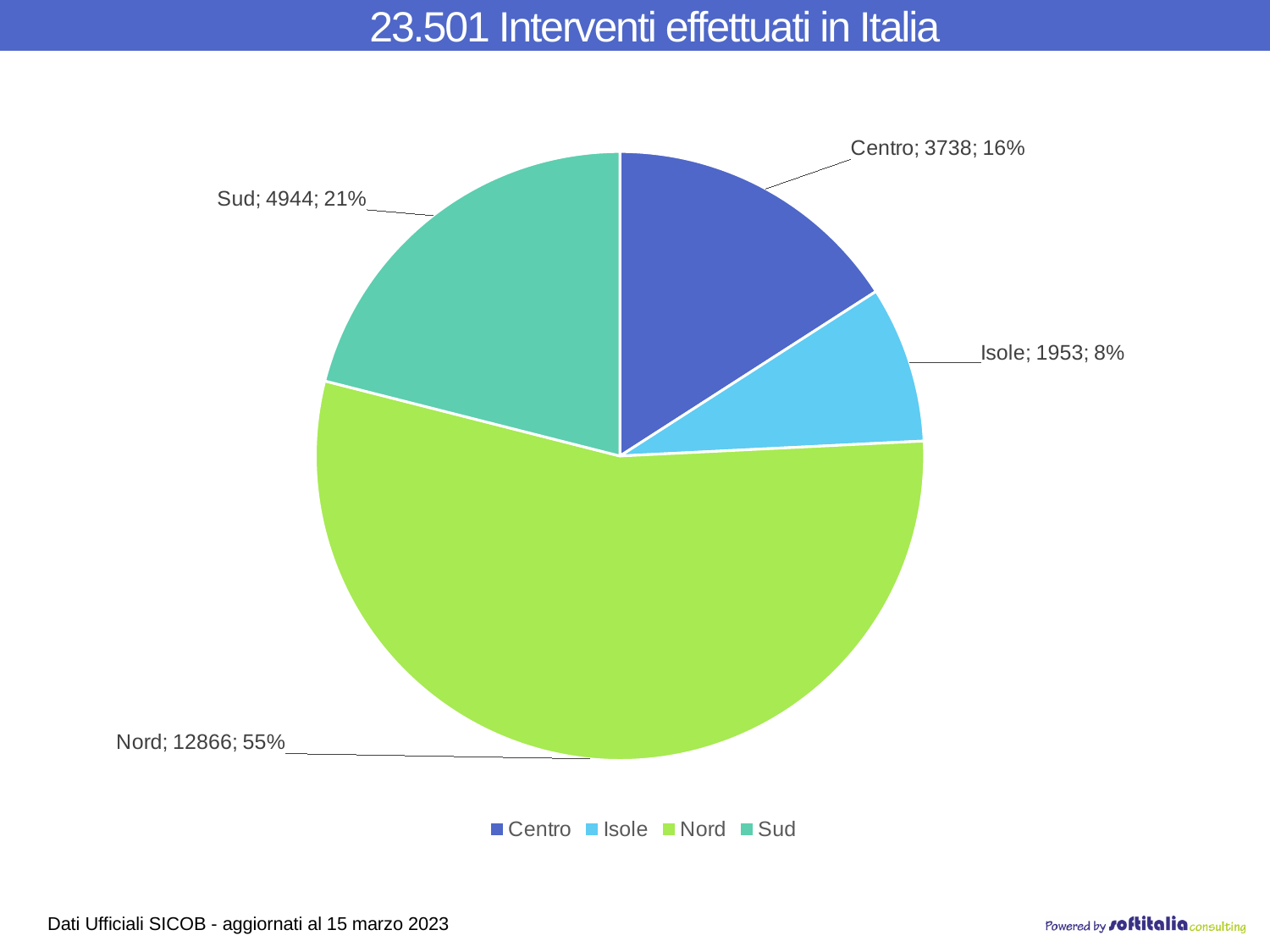
Which is larger, the value for Centro or the value for Isole? Centro How many slices does the pie chart have? 4 What is the value for Sud? 4944 Which region has the smallest slice? Isole Which region has the largest slice? Nord What is the difference between the values for Sud and Centro? 1206 What is the value for Centro? 3738 What share of the pie does Sud represent? 21% What is the value for Isole? 1953 What is the value for Nord? 12866 What share of the pie does Centro represent? 16% What type of chart is shown on the slide? pie chart